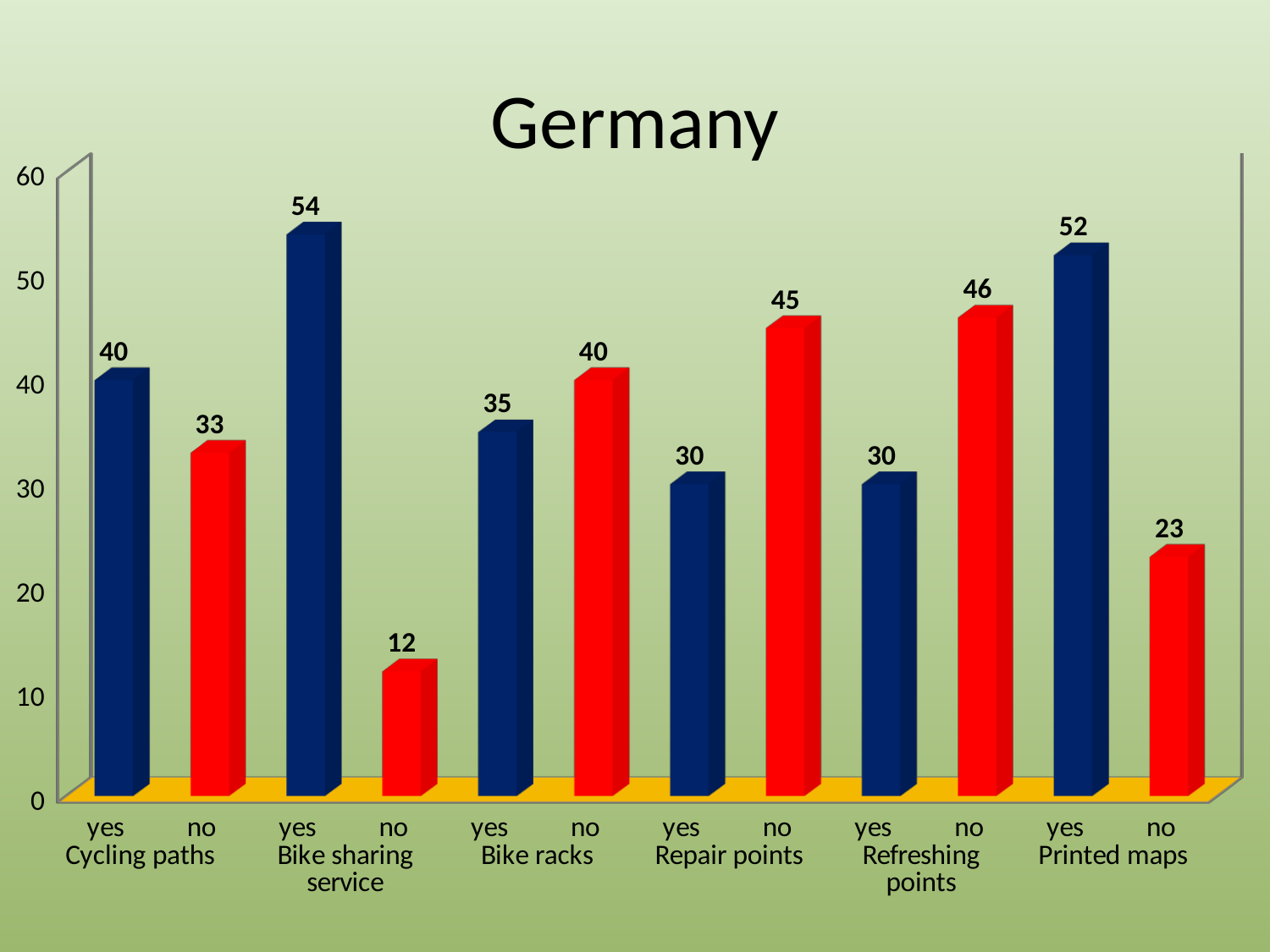
What is the value for 'yes' under Cycling paths? 40 How many bars are plotted on the chart? 12 What is the value for 'yes' under Printed maps? 52 Which bar has the lowest value on the chart? no, Bike sharing service What kind of chart is shown on the slide? bar chart What is the difference between the 'no' and 'yes' values for Repair points? 15 Which is larger for Bike racks, the 'yes' value or the 'no' value? no What is the difference between the 'yes' and 'no' values for Printed maps? 29 Which bar has the highest value on the chart? yes, Bike sharing service What is the value for 'no' under Refreshing points? 46 What is the title of the chart? Germany What is the value for 'no' under Bike sharing service? 12